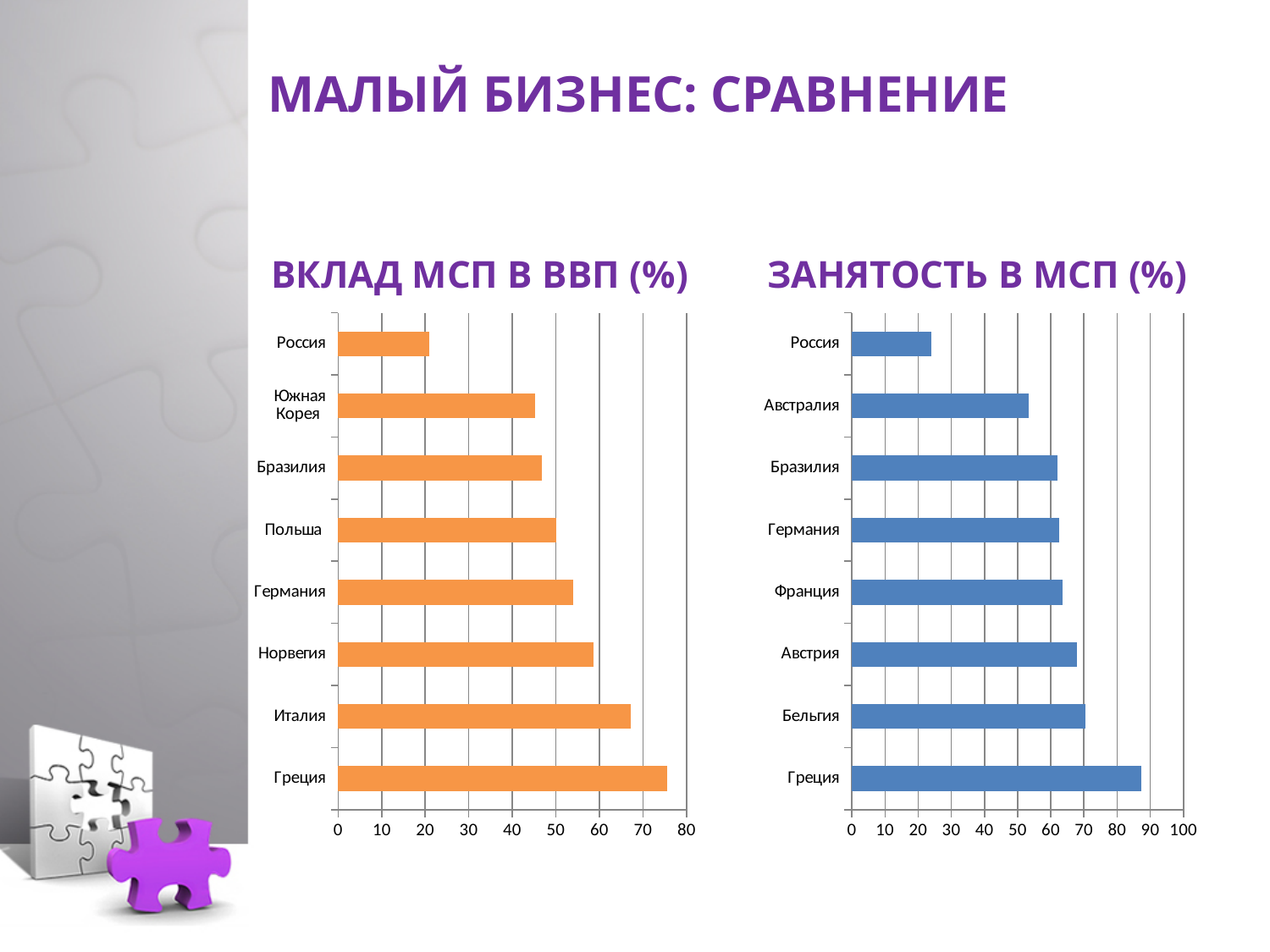
On the chart titled ВКЛАД МСП В ВВП (%), is the value for Италия greater or less than 60? greater How many countries are shown on the chart titled ВКЛАД МСП В ВВП (%)? 8 On the chart titled ЗАНЯТОСТЬ В МСП (%), which is larger, the value for Австралия or the value for Бельгия? Бельгия On the chart titled ЗАНЯТОСТЬ В МСП (%), which country has the lowest value? Россия On the chart titled ЗАНЯТОСТЬ В МСП (%), is the value for Греция greater or less than 80? greater What kind of chart is the chart titled ЗАНЯТОСТЬ В МСП (%)? bar chart On the chart titled ЗАНЯТОСТЬ В МСП (%), which country has the highest value? Греция On the chart titled ВКЛАД МСП В ВВП (%), is the value for Россия greater or less than 30? less What is the title of the chart on the right side of the slide? ЗАНЯТОСТЬ В МСП (%) On the chart titled ВКЛАД МСП В ВВП (%), which is larger, the value for Норвегия or the value for Польша? Норвегия On the chart titled ВКЛАД МСП В ВВП (%), which country has the lowest value? Россия On the chart titled ВКЛАД МСП В ВВП (%), which country has the highest value? Греция